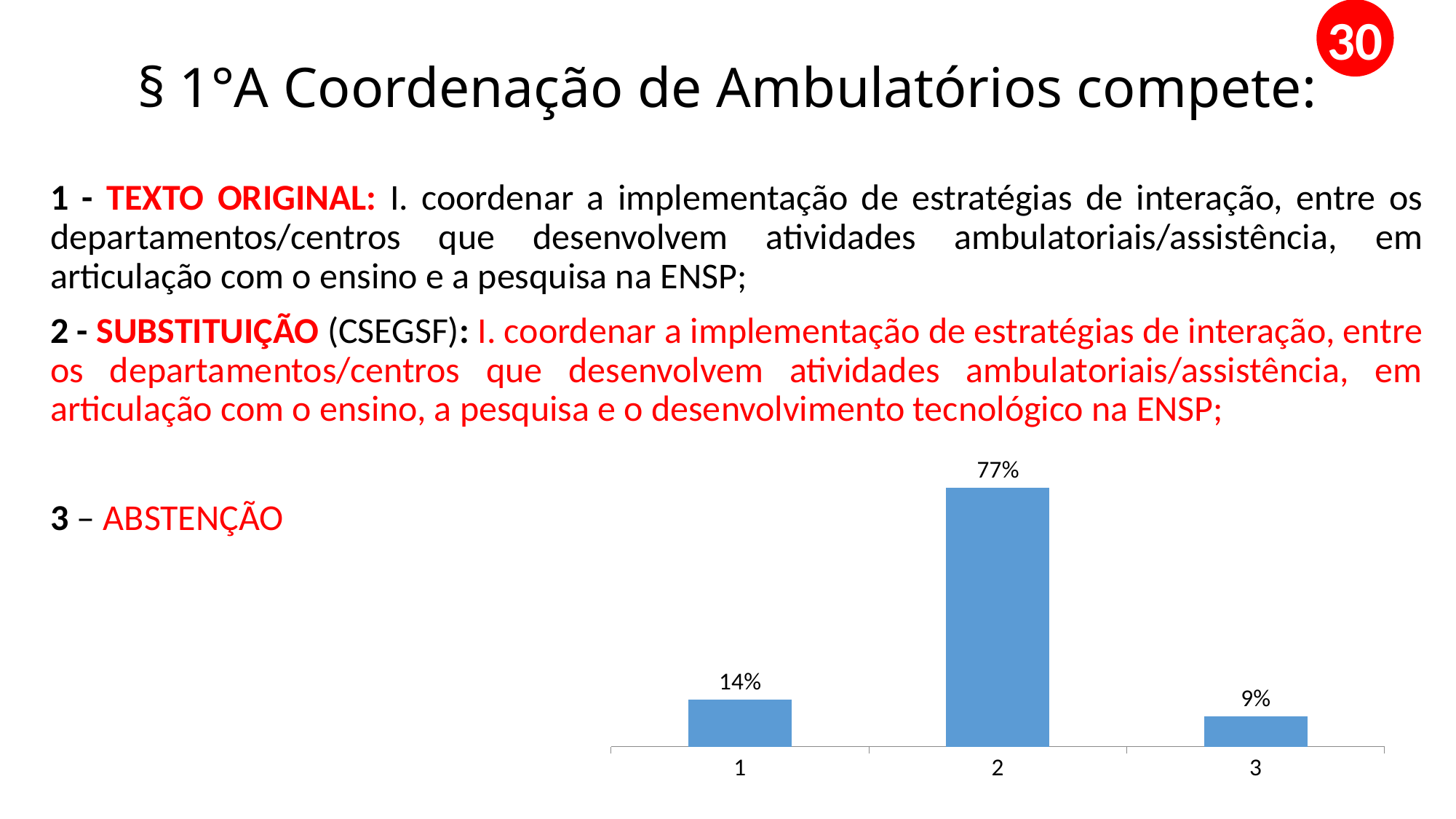
Which is larger, the value for category 1 or category 3? 1 What is the total of the three values shown in the chart? 100% What is the difference between the values for category 1 and category 3? 5% What is the value for category 3? 9% What is the value for category 2? 77% How many categories are shown on the x axis? 3 What is the difference between the values for category 2 and category 1? 63% Which category has the lowest value? 3 What kind of chart is shown on the slide? bar chart What is the value for category 1? 14% Which category has the highest value? 2 What colour are the bars in the chart? blue